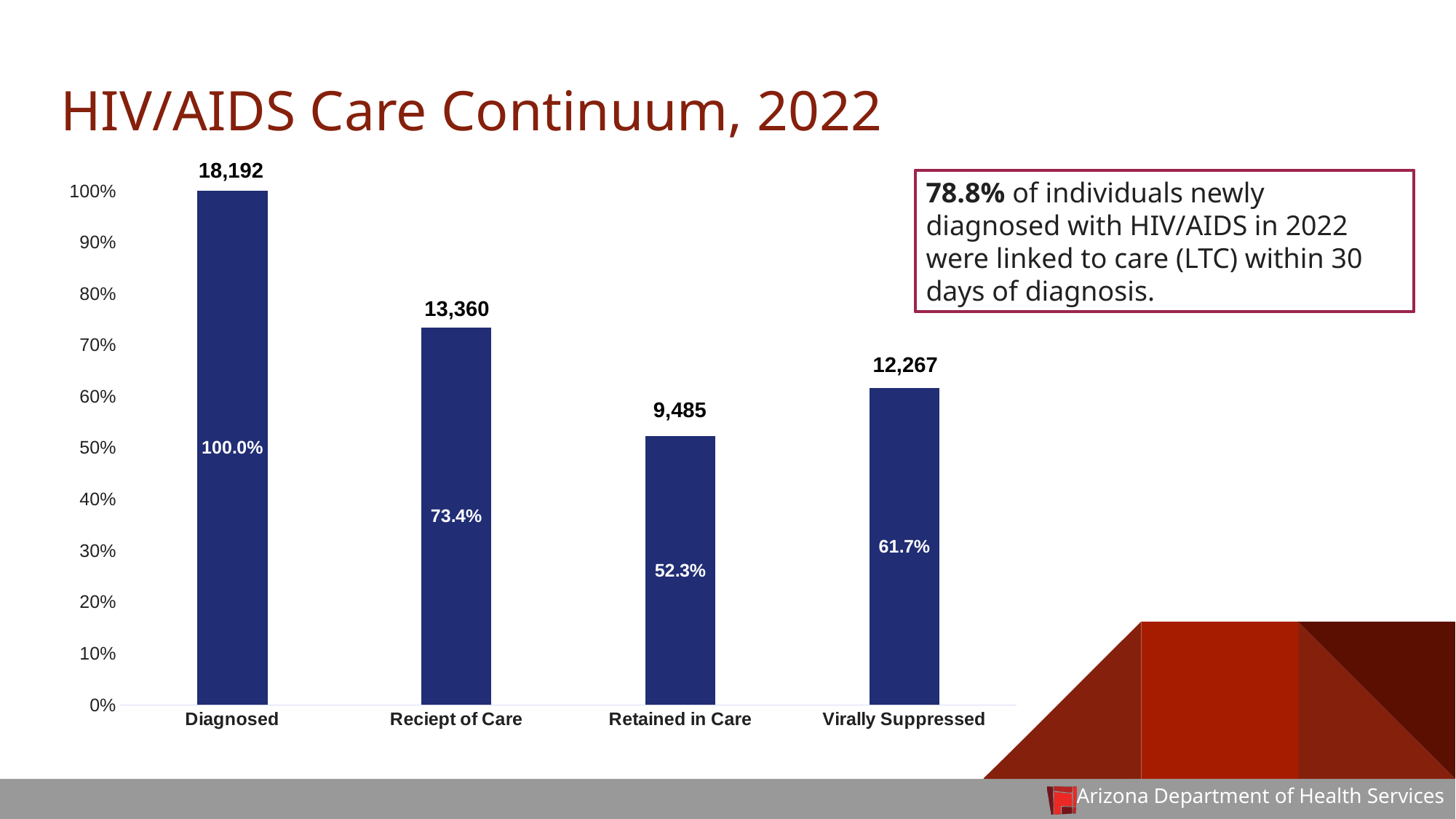
What kind of chart is shown on the slide? Bar chart How many categories are shown on the x axis? 4 Which category has the highest value? Diagnosed What is the difference in percentage between Virally Suppressed and Retained in Care? 9.4% What is the difference in count between Diagnosed and Reciept of Care? 4,832 What is the count shown for Diagnosed? 18,192 What is the count shown for Virally Suppressed? 12,267 What is the title of the slide? HIV/AIDS Care Continuum, 2022 What percentage is shown on the Reciept of Care bar? 73.4% Which category has the lowest value? Retained in Care What percentage is shown on the Retained in Care bar? 52.3% Which is larger, the value for Reciept of Care or the value for Virally Suppressed? Reciept of Care